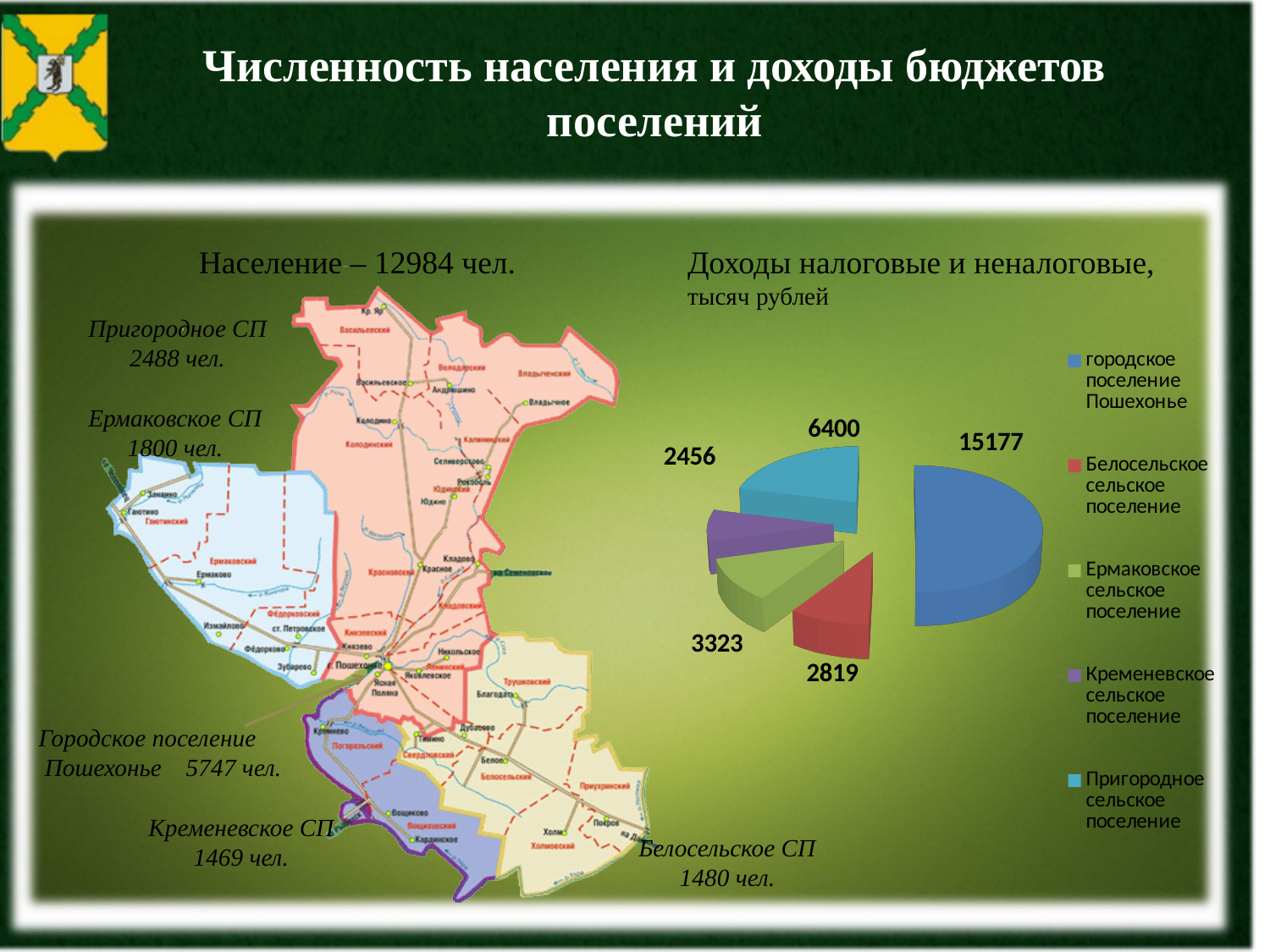
Which is larger in the pie chart: Ермаковское сельское поселение or Белосельское сельское поселение? Ермаковское сельское поселение How many slices does the pie chart have? 5 What is the value for Пригородное сельское поселение in the pie chart? 6400 What is the difference between the values for городское поселение Пошехонье and Пригородное сельское поселение? 8777 What is the value for городское поселение Пошехонье in the pie chart? 15177 Which settlement has the smallest slice in the pie chart? Кременевское сельское поселение What is the value for Белосельское сельское поселение in the pie chart? 2819 What is the total of all values shown in the pie chart? 30175 What type of chart is shown on the slide? Pie chart Which settlement has the largest slice in the pie chart? городское поселение Пошехонье What unit is stated for the income values in the pie chart? тысяч рублей What is the value for Кременевское сельское поселение in the pie chart? 2456